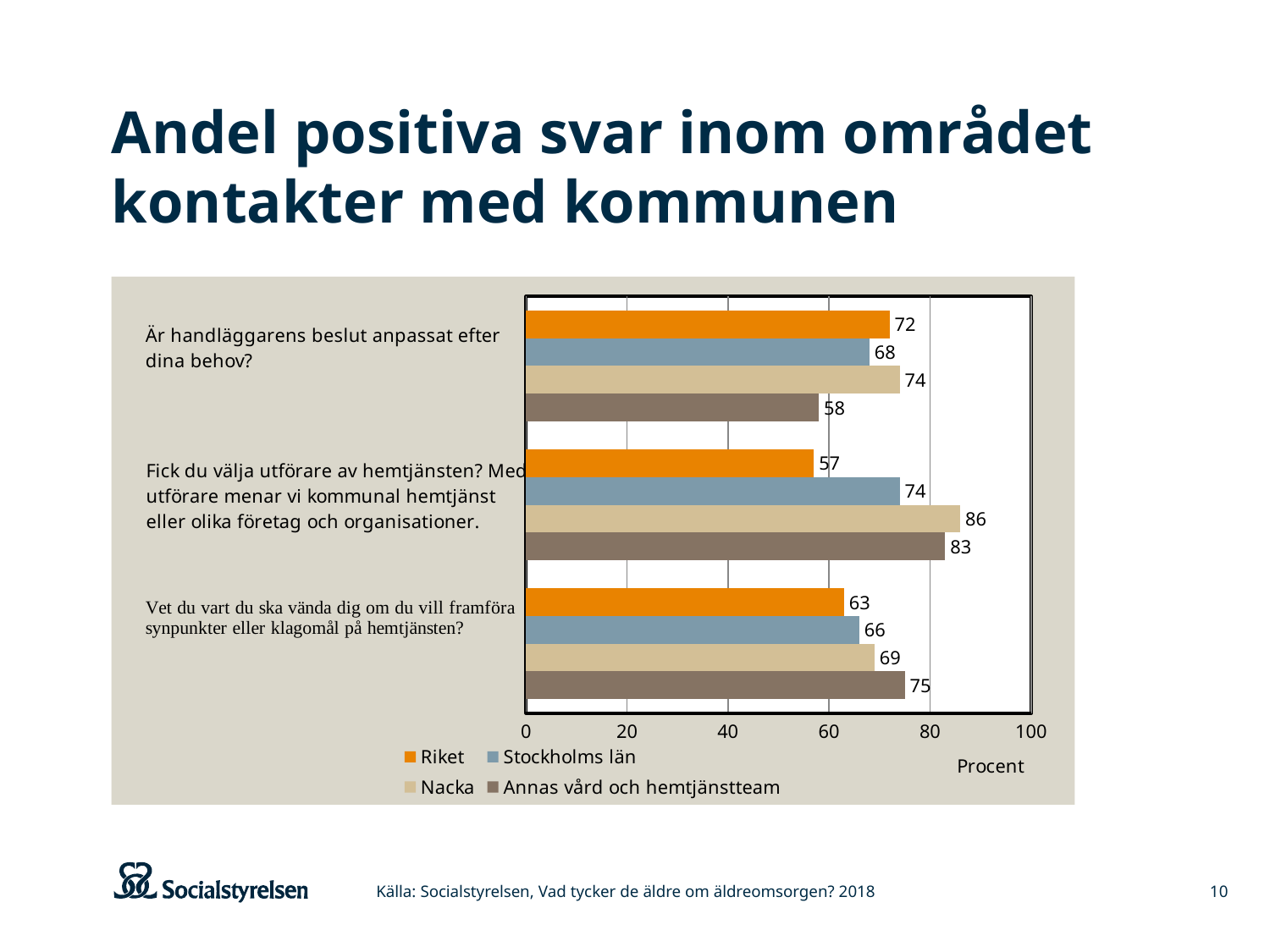
What kind of chart is shown on the slide? Bar chart What unit is shown on the horizontal axis of the chart? Procent How many question categories are shown on the chart? 3 What is the value for Nacka on the question "Fick du välja utförare av hemtjänsten?"? 86 What is the value for Riket on the question "Är handläggarens beslut anpassat efter dina behov?"? 72 How many series does the legend list? 4 What is the value for Stockholms län on the question "Fick du välja utförare av hemtjänsten?"? 74 What is the value for Annas vård och hemtjänstteam on the question "Vet du vart du ska vända dig om du vill framföra synpunkter eller klagomål på hemtjänsten?"? 75 What is the difference between the Nacka and Riket values on the question "Fick du välja utförare av hemtjänsten?"? 29 Which series has the lowest value on the question "Är handläggarens beslut anpassat efter dina behov?"? Annas vård och hemtjänstteam Which is larger on the question "Vet du vart du ska vända dig om du vill framföra synpunkter eller klagomål på hemtjänsten?": Riket or Annas vård och hemtjänstteam? Annas vård och hemtjänstteam Which series has the highest value on the question "Fick du välja utförare av hemtjänsten?"? Nacka